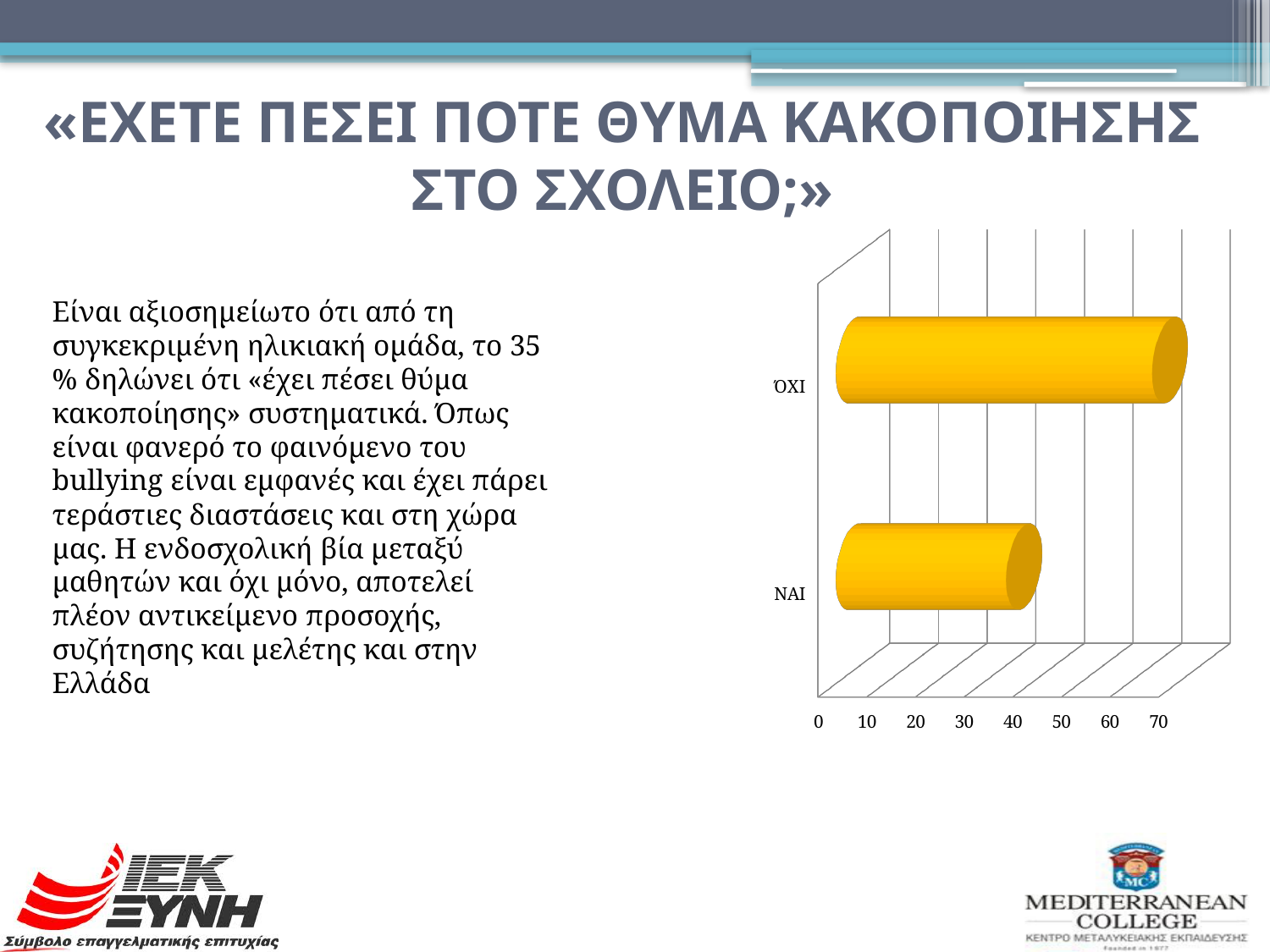
Which category has the highest value in the chart? ΌΧΙ Is the value for ΝΑΙ greater or less than 60? less What colour are the bars in the chart? yellow Which category has the lowest value in the chart? ΝΑΙ Is the value for ΌΧΙ greater or less than 60? greater Is the value for ΌΧΙ greater or less than 50? greater What kind of chart is shown on the slide? bar chart How many categories does the chart show? 2 What is the highest value shown on the chart's value axis? 70 Which is larger, the value for ΌΧΙ or the value for ΝΑΙ? ΌΧΙ